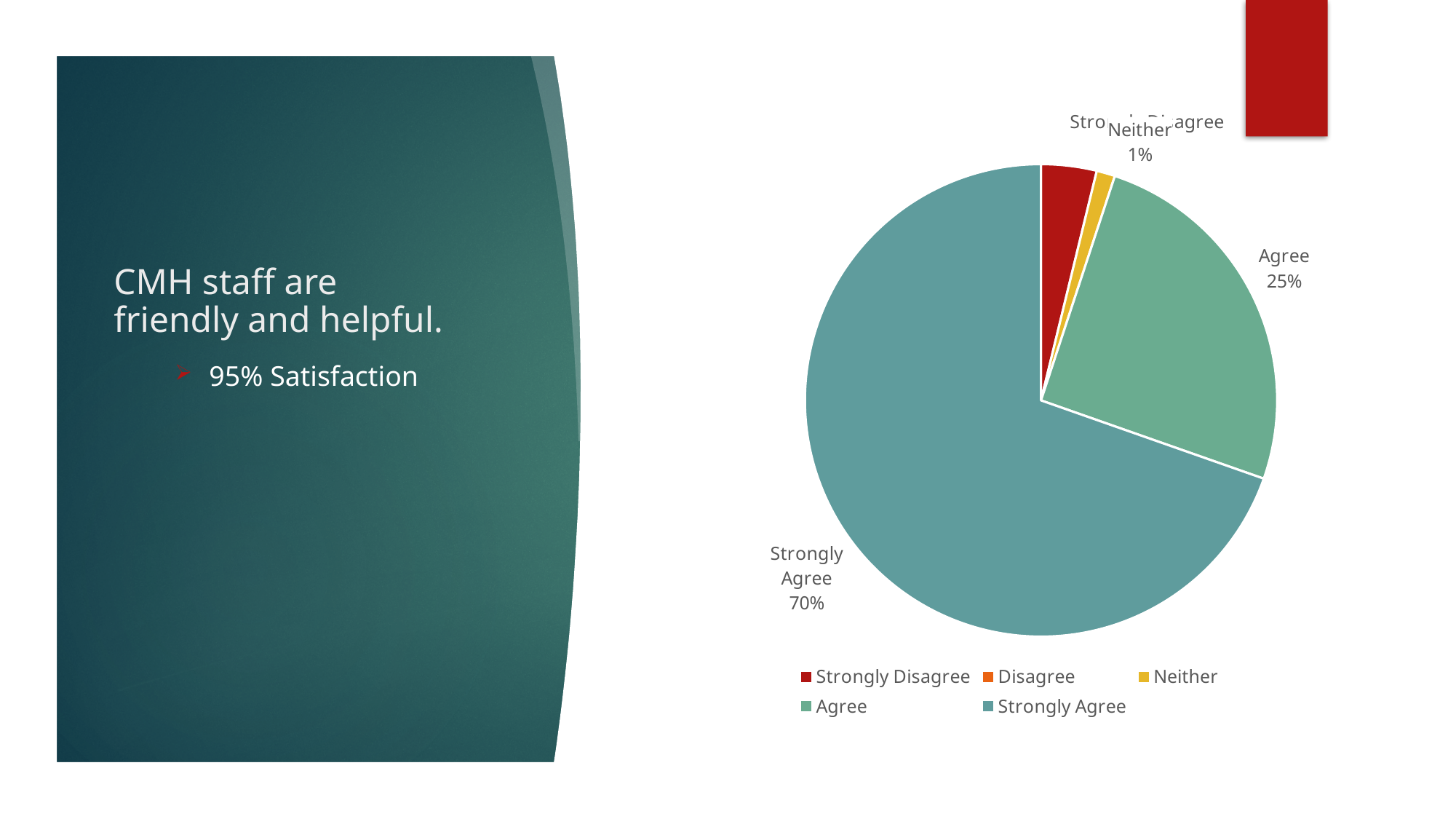
Which category has the largest slice of the pie? Strongly Agree What percentage of the pie is Strongly Agree? 70% What kind of chart is shown on the slide? pie chart What is the difference between the Strongly Agree and Agree percentages? 45% What satisfaction percentage is stated in the text next to the chart? 95% Satisfaction What colour is the Strongly Disagree slice? red What is the combined percentage of Agree and Strongly Agree? 95% What percentage of the pie is Agree? 25% What percentage of the pie is Neither? 1% How many categories does the legend list? 5 Which is larger, the Strongly Agree slice or the Agree slice? Strongly Agree Which is larger, the Agree slice or the Neither slice? Agree